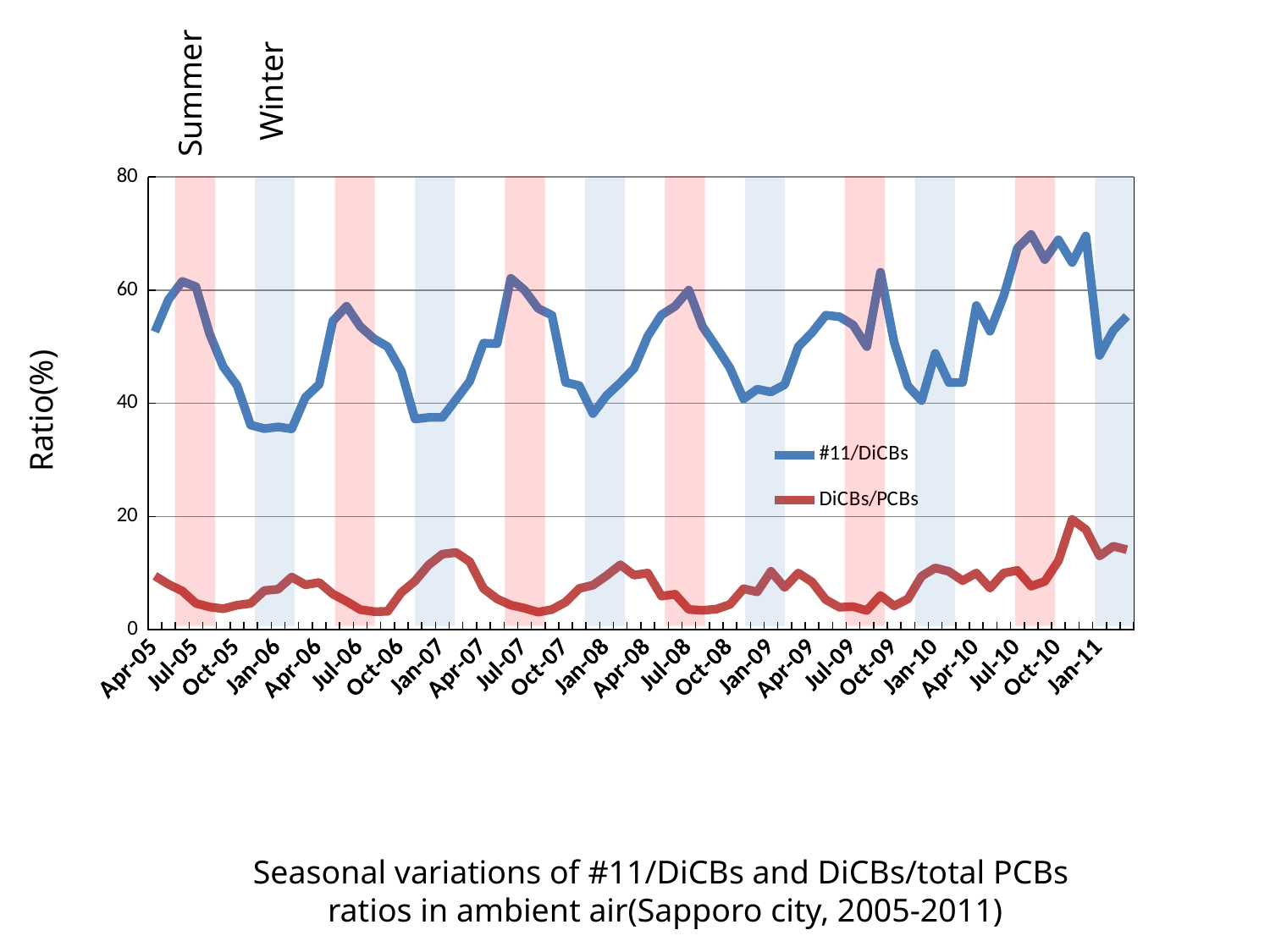
Is the value of #11/DiCBs at Jan-06 greater or less than 40? less Is the value of #11/DiCBs at Oct-10 greater or less than 60? greater Which series is drawn in red? DiCBs/PCBs How many series does the legend list? 2 How many tick labels are shown on the x axis? 24 Does the #11/DiCBs series rise or fall from Jul-05 to Jan-06? fall Is the value of DiCBs/PCBs at Jan-06 greater or less than 20? less At Jan-06, which series has the higher value, #11/DiCBs or DiCBs/PCBs? #11/DiCBs What kind of chart is shown on the slide? line chart Which series reaches the highest value on the chart? #11/DiCBs What is the label on the y axis? Ratio(%)